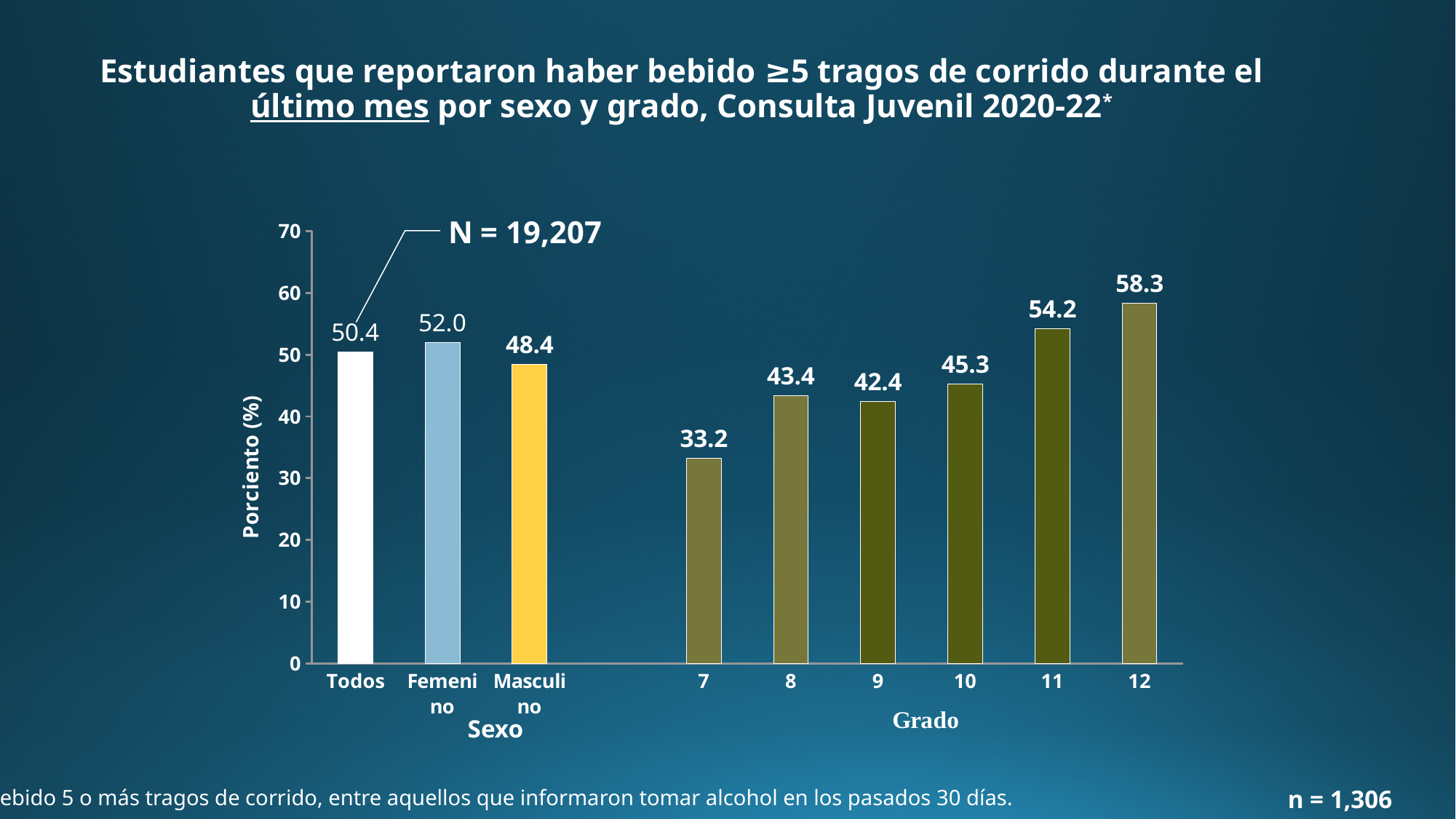
What is the value for grade 10? 45.3 What kind of chart is shown on the slide? bar chart What is the difference between the values for Femenino and Masculino? 3.6 Which is larger, the value for grade 8 or grade 9? grade 8 What is the value for grade 7? 33.2 How many grade categories are shown on the chart? 6 Which grade has the lowest value? 7 What is the N value shown next to the Todos bar? N = 19,207 Which grade has the highest value? 12 What is the value for Todos? 50.4 What is the difference between the values for grade 12 and grade 7? 25.1 What is the value for Femenino? 52.0